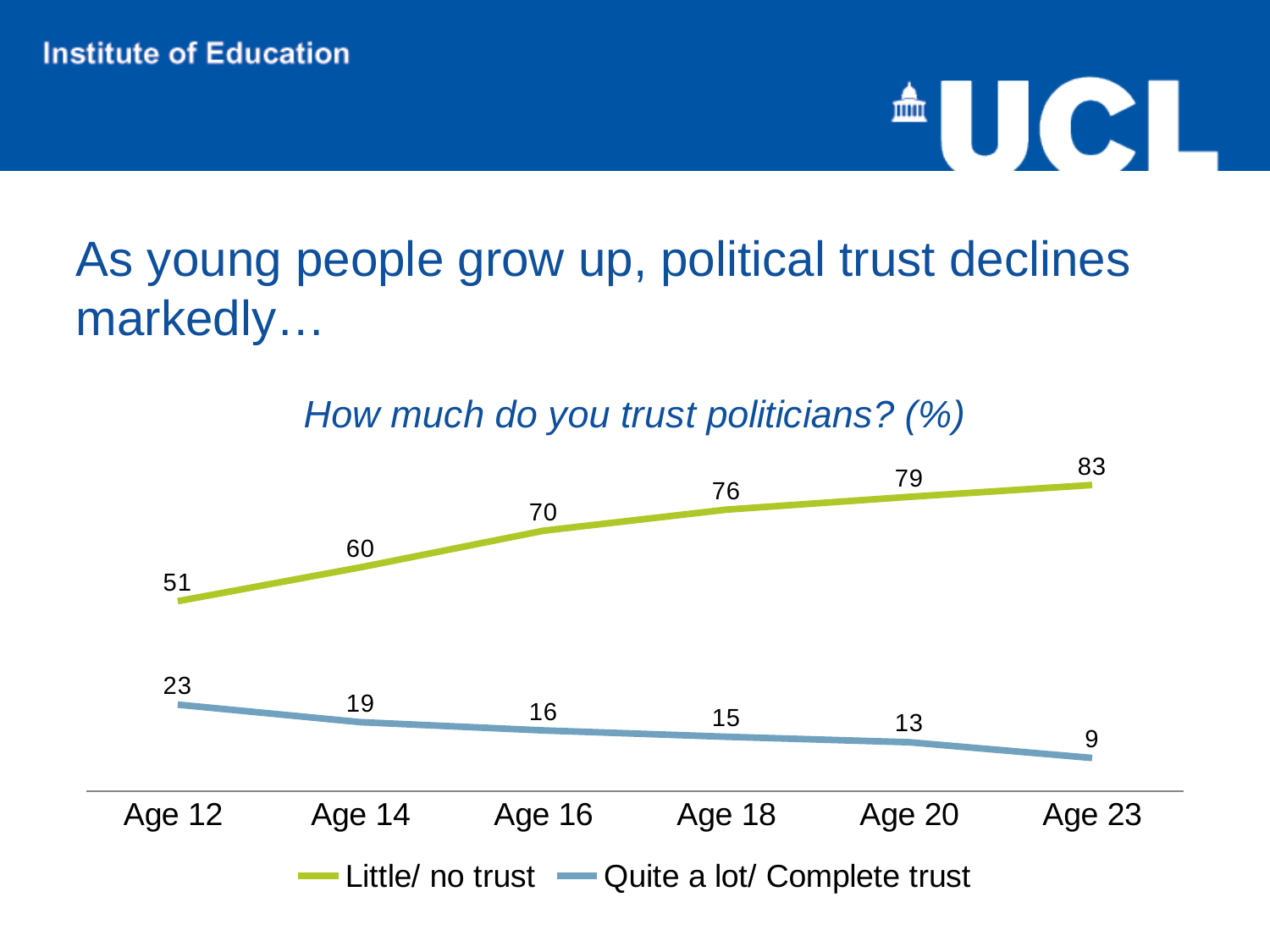
What is the value for 'Little/ no trust' at Age 12? 51 What is the difference between 'Quite a lot/ Complete trust' at Age 12 and at Age 20? 10 How many age points are plotted on the x axis? 6 What kind of chart is shown? Line chart What is the value for 'Quite a lot/ Complete trust' at Age 23? 9 What is the difference between 'Little/ no trust' at Age 23 and at Age 12? 32 How many series does the legend list? 2 Does 'Quite a lot/ Complete trust' rise or fall from Age 12 to Age 23? Fall What is the value for 'Little/ no trust' at Age 18? 76 At which age is 'Little/ no trust' highest? Age 23 At which age is 'Quite a lot/ Complete trust' lowest? Age 23 Which is larger at Age 16: 'Little/ no trust' or 'Quite a lot/ Complete trust'? Little/ no trust